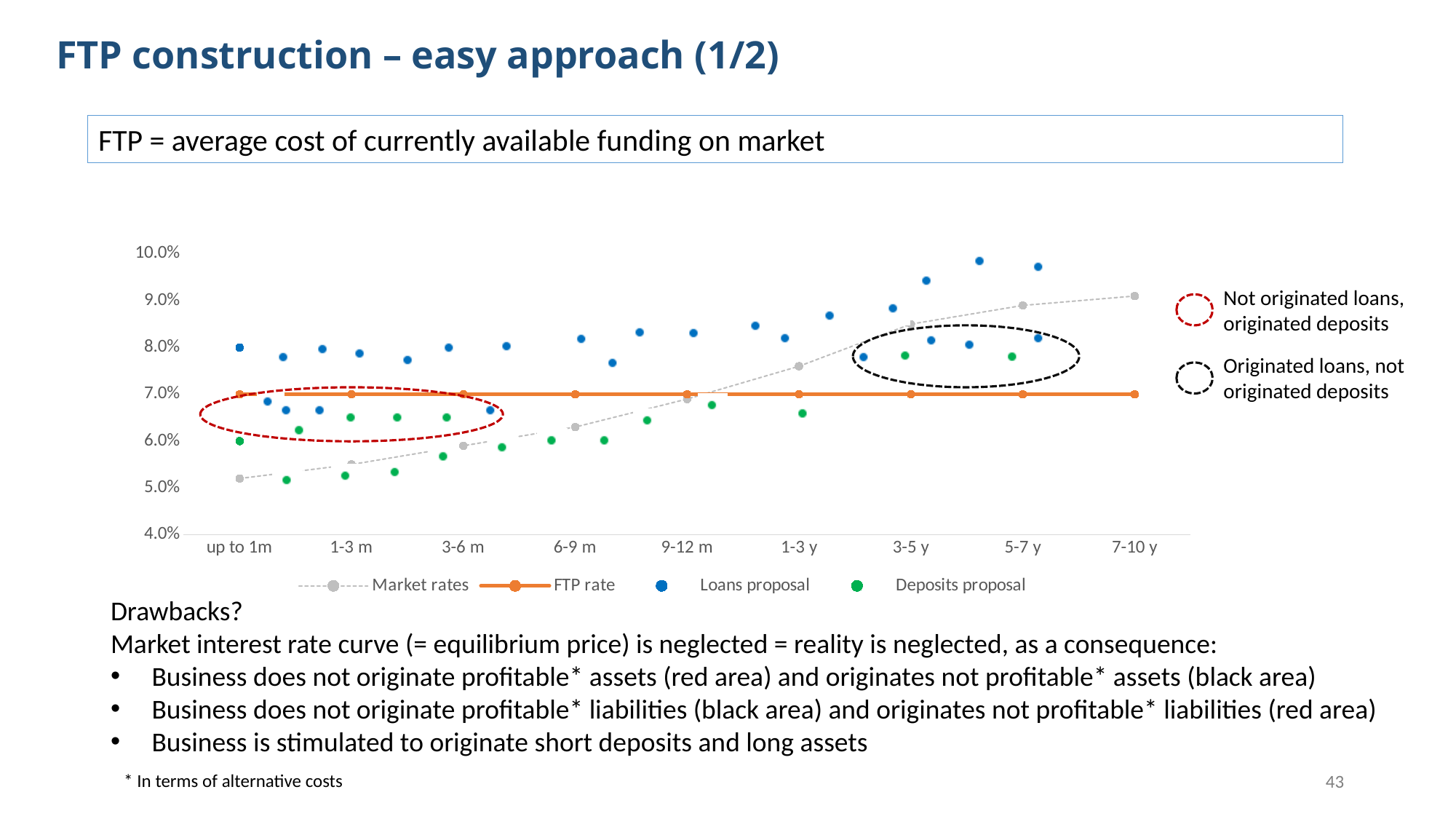
What is the FTP rate at the 1-3 y category? 7.0% Which is larger: the Market rates value at 7-10 y or at up to 1m? 7-10 y How many series does the legend list? 4 Is the Market rates value for 3-6 m greater or less than 7.0%? less Do the Market rates values rise or fall from up to 1m to 7-10 y? rise At which category is the Market rates series highest? 7-10 y At which category is the Market rates series lowest? up to 1m What is the FTP rate at the 7-10 y category? 7.0% Is the Market rates value for up to 1m greater or less than 6.0%? less Is the Market rates value for 1-3 y greater or less than 7.0%? greater How many categories are shown on the x axis? 9